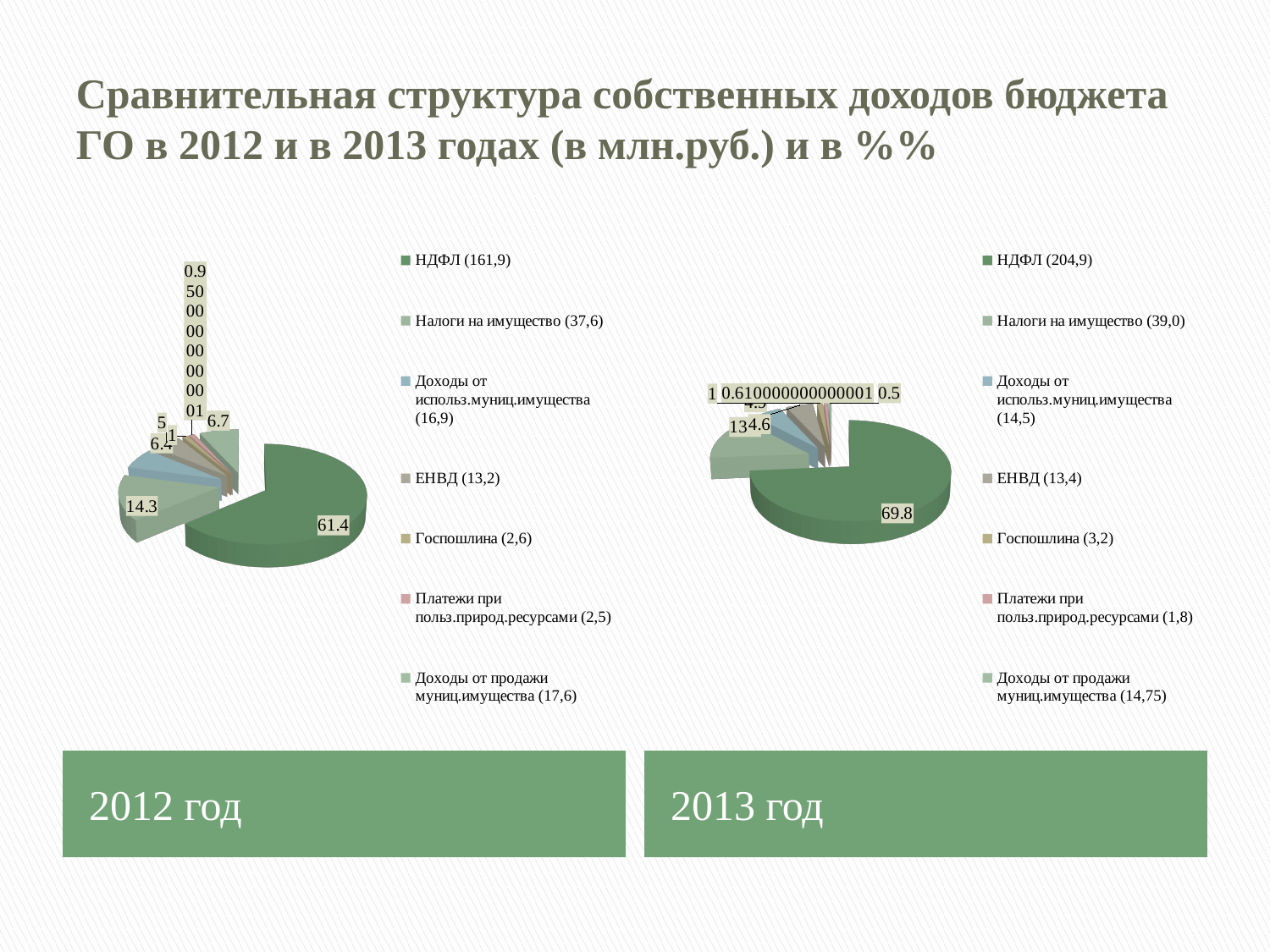
In the 2012 год chart, what share of the pie is labelled for the НДФЛ slice? 61.4 In the 2013 год chart, what value (in млн.руб.) does the legend give for НДФЛ? 204,9 In the 2013 год chart, what value does the legend give for Налоги на имущество? 39,0 In the 2012 год chart, what value does the legend give for Доходы от продажи муниц.имущества? 17,6 In the 2013 год chart, what share of the pie is labelled for the НДФЛ slice? 69.8 In the 2012 год chart, what value (in млн.руб.) does the legend give for НДФЛ? 161,9 Which is larger: the legend value for Госпошлина in the 2012 год chart or in the 2013 год chart? 2013 год (3,2) What type of chart is used for the 2012 год chart? pie chart In the 2012 год chart, how many categories does the legend list? 7 By how much does the legend value for НДФЛ in the 2013 год chart exceed that in the 2012 год chart? 43,0 In the 2013 год chart, which category has the largest slice? НДФЛ In the 2012 год chart, what share of the pie is labelled for the Налоги на имущество slice? 14.3